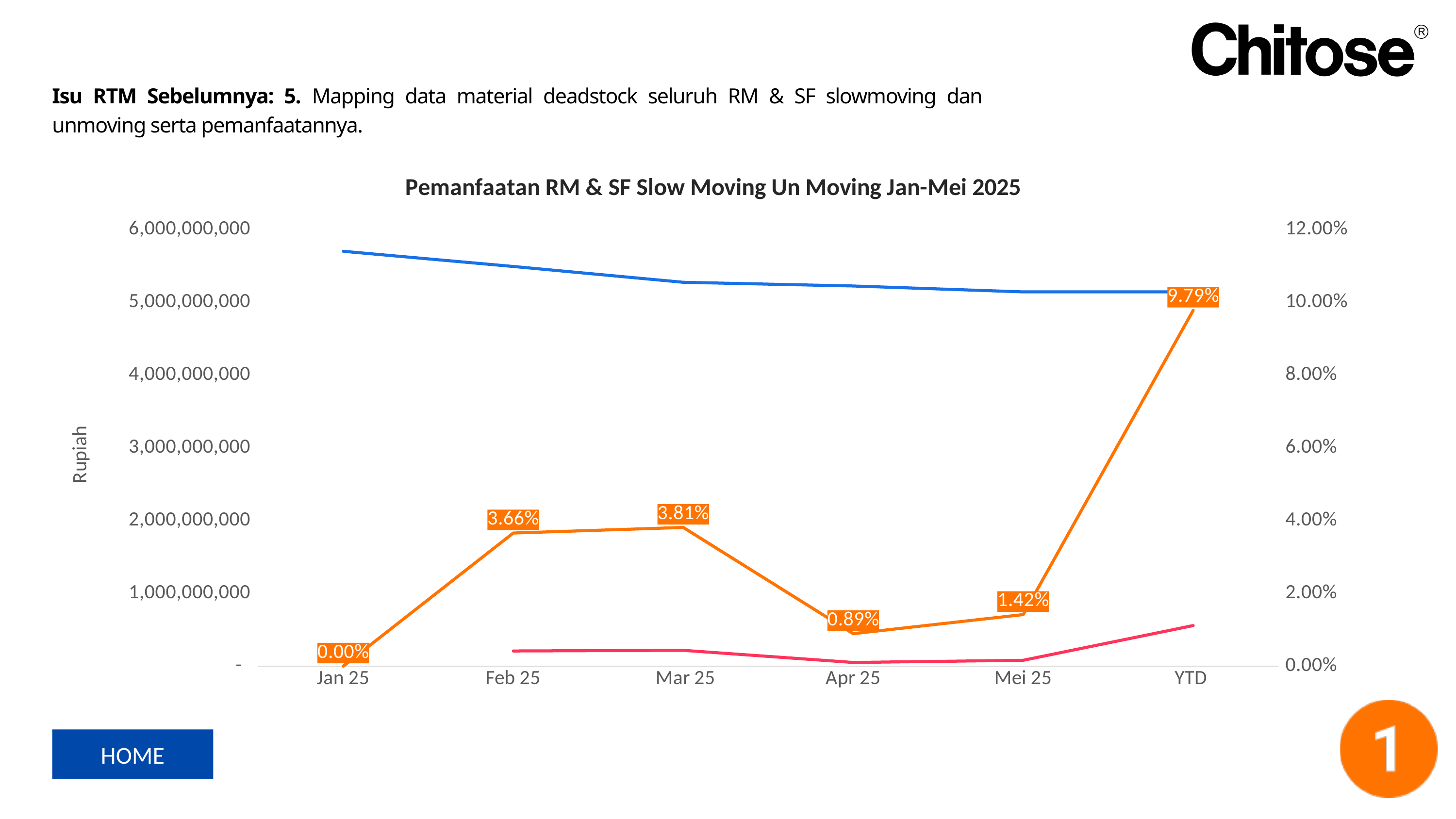
On the orange line, which is larger: the value for Mei 25 or the value for Apr 25? Mei 25 Is the value of the blue line for Jan 25 greater or less than 5,000,000,000? greater What is the percentage value labelled on the orange line for YTD? 9.79% Which category has the lowest percentage value on the orange line? Jan 25 What kind of chart is shown on the slide? line chart What is the difference between the orange line's percentage values for Mar 25 and Feb 25? 0.15% What is the percentage value labelled on the orange line for Mar 25? 3.81% What is the percentage value labelled on the orange line for Apr 25? 0.89% What is the percentage value labelled on the orange line for Feb 25? 3.66% Which category has the highest percentage value on the orange line? YTD What is the chart's title? Pemanfaatan RM & SF Slow Moving Un Moving Jan-Mei 2025 How many categories are shown on the x axis? 6